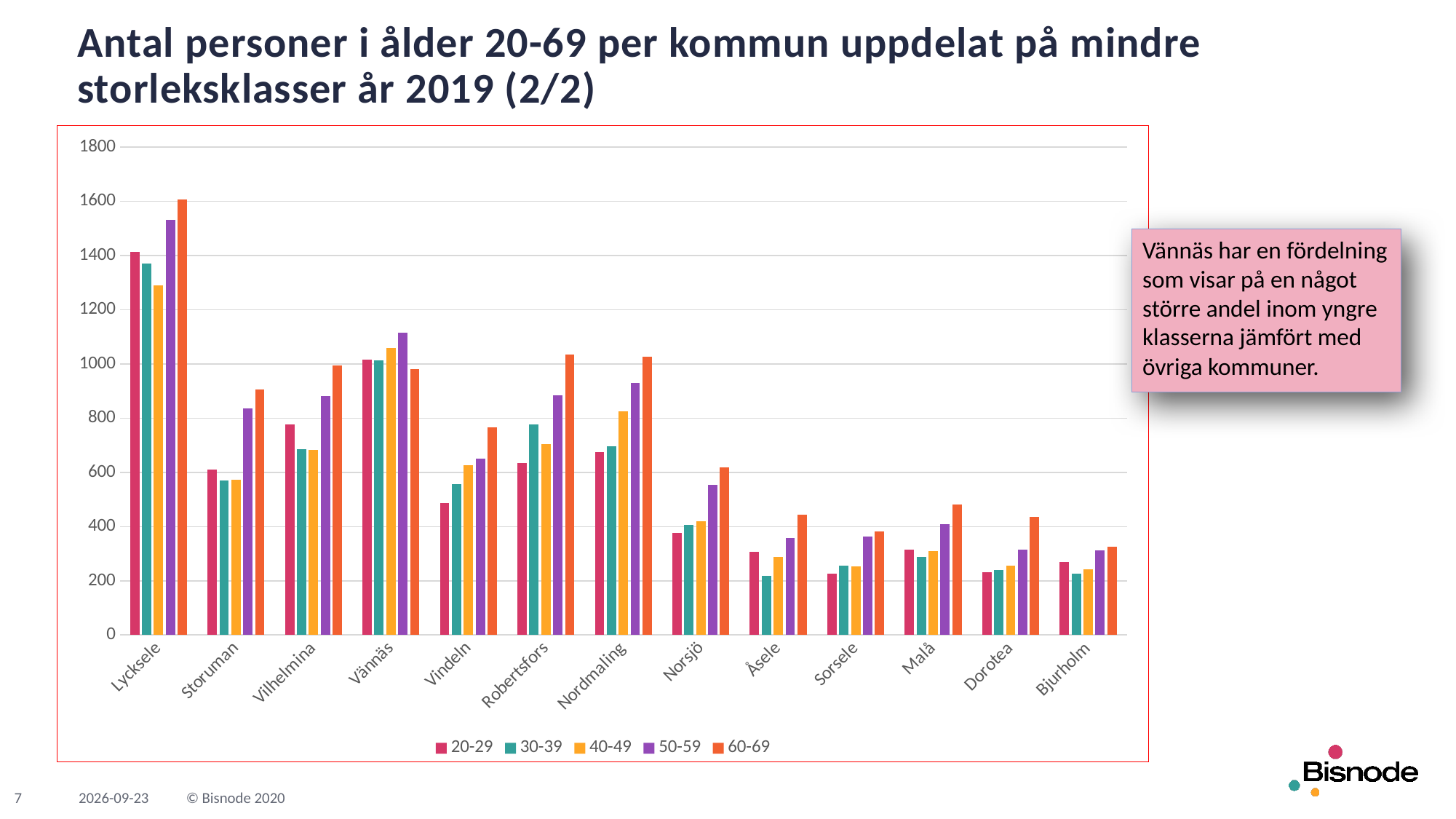
Which is larger: the 50-59 value for Storuman or the 50-59 value for Vilhelmina? Vilhelmina What kind of chart is shown on the slide? bar chart Is the value for the 60-69 group in Lycksele greater or less than 1400? greater Which municipality has the highest bar for the 20-29 age group? Lycksele Which age group is shown in orange in the legend? 60-69 How many age-group series does the legend list? 5 Which municipality has the lowest bar for the 60-69 age group? Bjurholm Which municipality has the highest bar for the 60-69 age group? Lycksele Which is larger: the 60-69 value for Vindeln or the 60-69 value for Robertsfors? Robertsfors Is the value for the 50-59 group in Vännäs greater or less than 1000? greater How many municipalities are shown on the x axis of the chart? 13 Is the value for the 60-69 group in Malå greater or less than 600? less